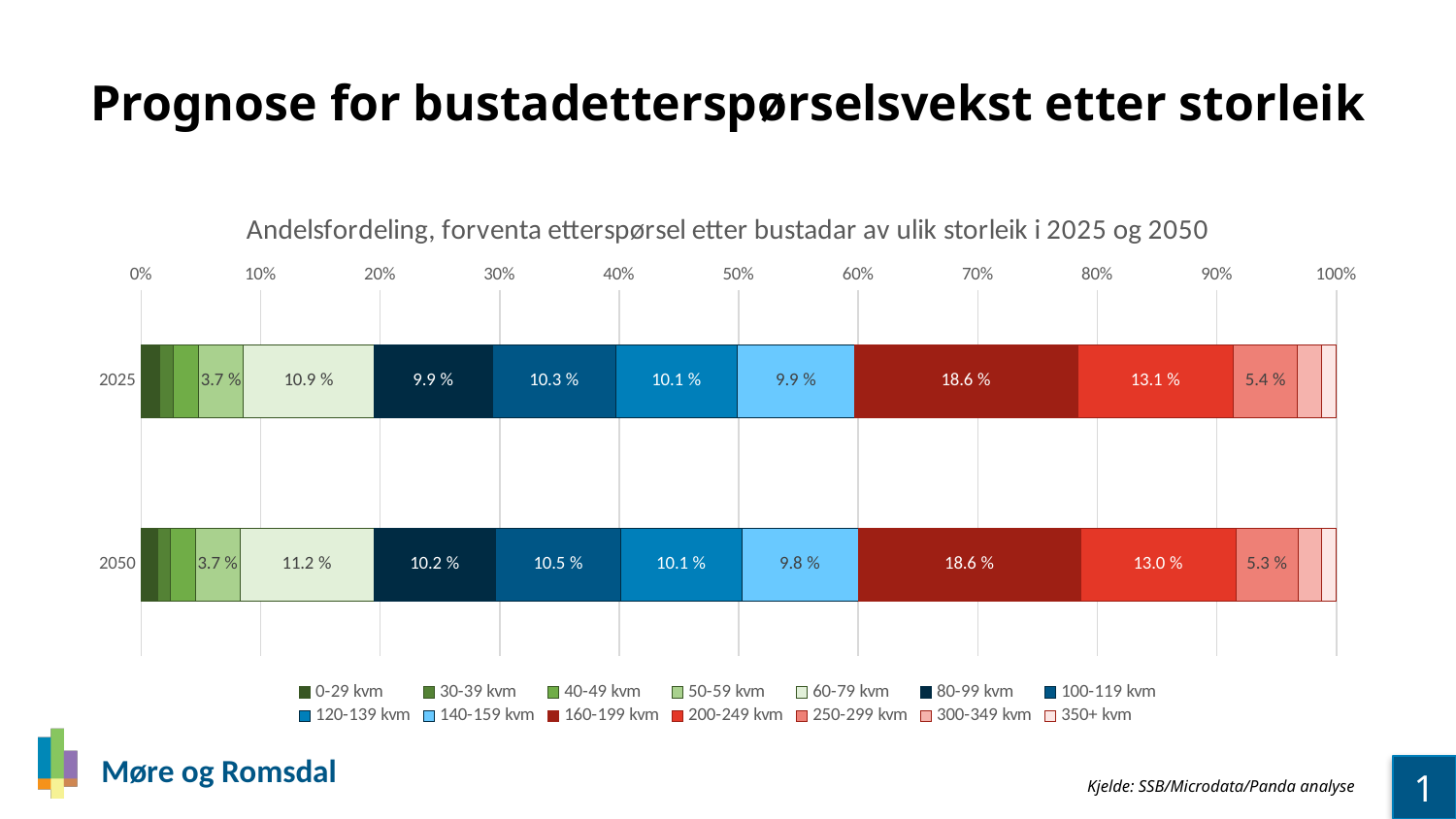
Which size category has the largest share in the 2050 bar? 160-199 kvm What type of chart is shown on the slide? Stacked bar chart What is the share for 250-299 kvm in 2050? 5.3 % How many categories (years) are plotted on the chart? 2 Which is larger: the 80-99 kvm share in 2025 or in 2050? 2050 Which is larger in 2025: the 100-119 kvm share or the 140-159 kvm share? 100-119 kvm What is the share for 60-79 kvm in 2050? 11.2 % What is the share for 160-199 kvm in 2025? 18.6 % What is the difference between the 60-79 kvm share in 2050 and in 2025? 0.3 percentage points How many series does the legend list? 14 What is the title of the chart? Andelsfordeling, forventa etterspørsel etter bustadar av ulik storleik i 2025 og 2050 What is the share for 200-249 kvm in 2025? 13.1 %